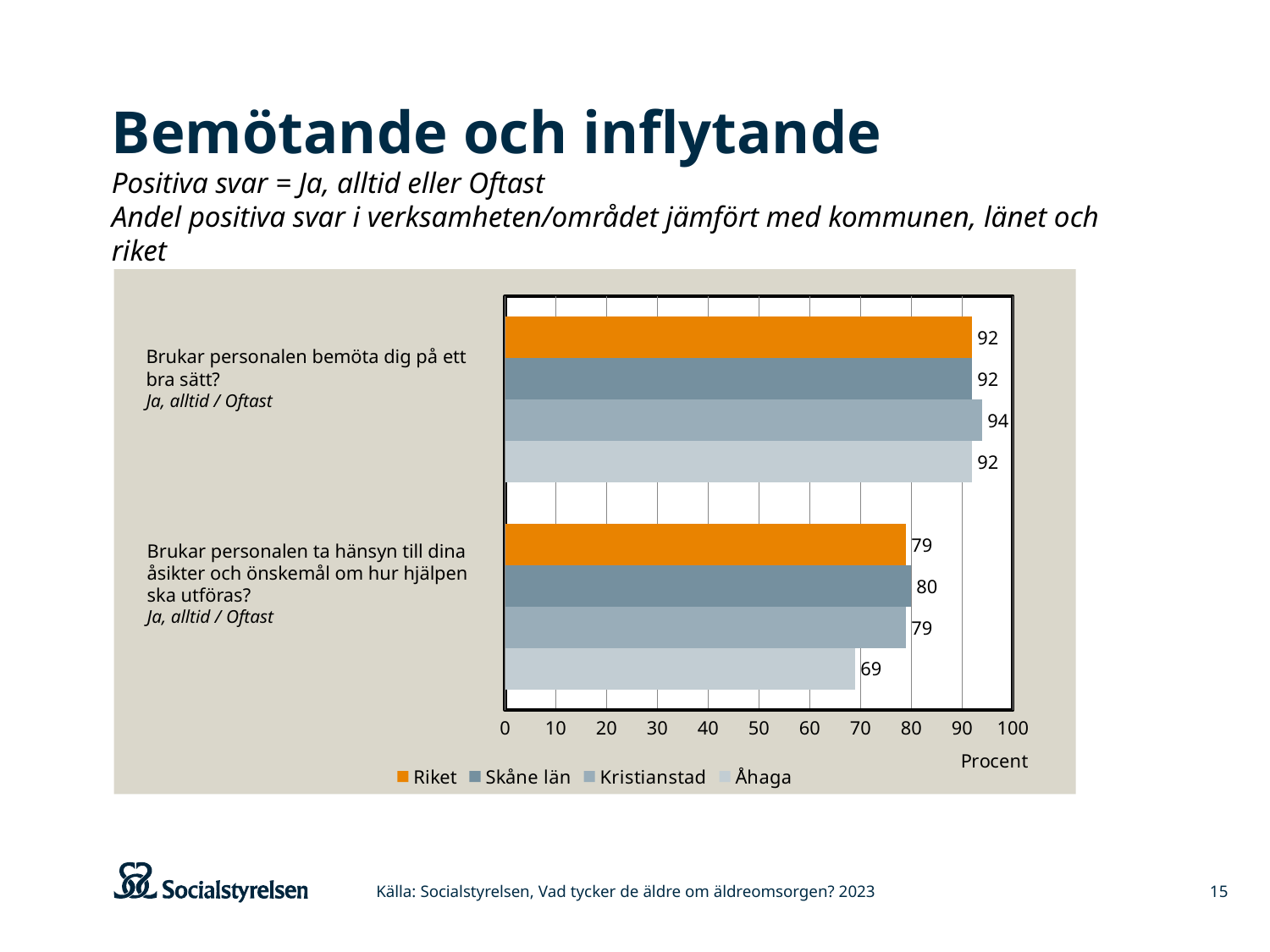
What is the value for Riket for the question "Brukar personalen bemöta dig på ett bra sätt?"? 92 What is the value for Kristianstad for the question "Brukar personalen bemöta dig på ett bra sätt?"? 94 Which series has the highest value for the question "Brukar personalen bemöta dig på ett bra sätt?"? Kristianstad What type of chart is shown on the slide? bar chart What is the difference between the Kristianstad value and the Åhaga value for the question "Brukar personalen ta hänsyn till dina åsikter och önskemål om hur hjälpen ska utföras?"? 10 How many series does the legend list? 4 What is the difference between the Åhaga values for the two questions? 23 What is the value for Åhaga for the question "Brukar personalen ta hänsyn till dina åsikter och önskemål om hur hjälpen ska utföras?"? 69 What is the label of the x axis? Procent Which is larger: the Riket value or the Åhaga value for the question "Brukar personalen ta hänsyn till dina åsikter och önskemål om hur hjälpen ska utföras?"? Riket What is the value for Skåne län for the question "Brukar personalen ta hänsyn till dina åsikter och önskemål om hur hjälpen ska utföras?"? 80 Which series has the lowest value for the question "Brukar personalen ta hänsyn till dina åsikter och önskemål om hur hjälpen ska utföras?"? Åhaga